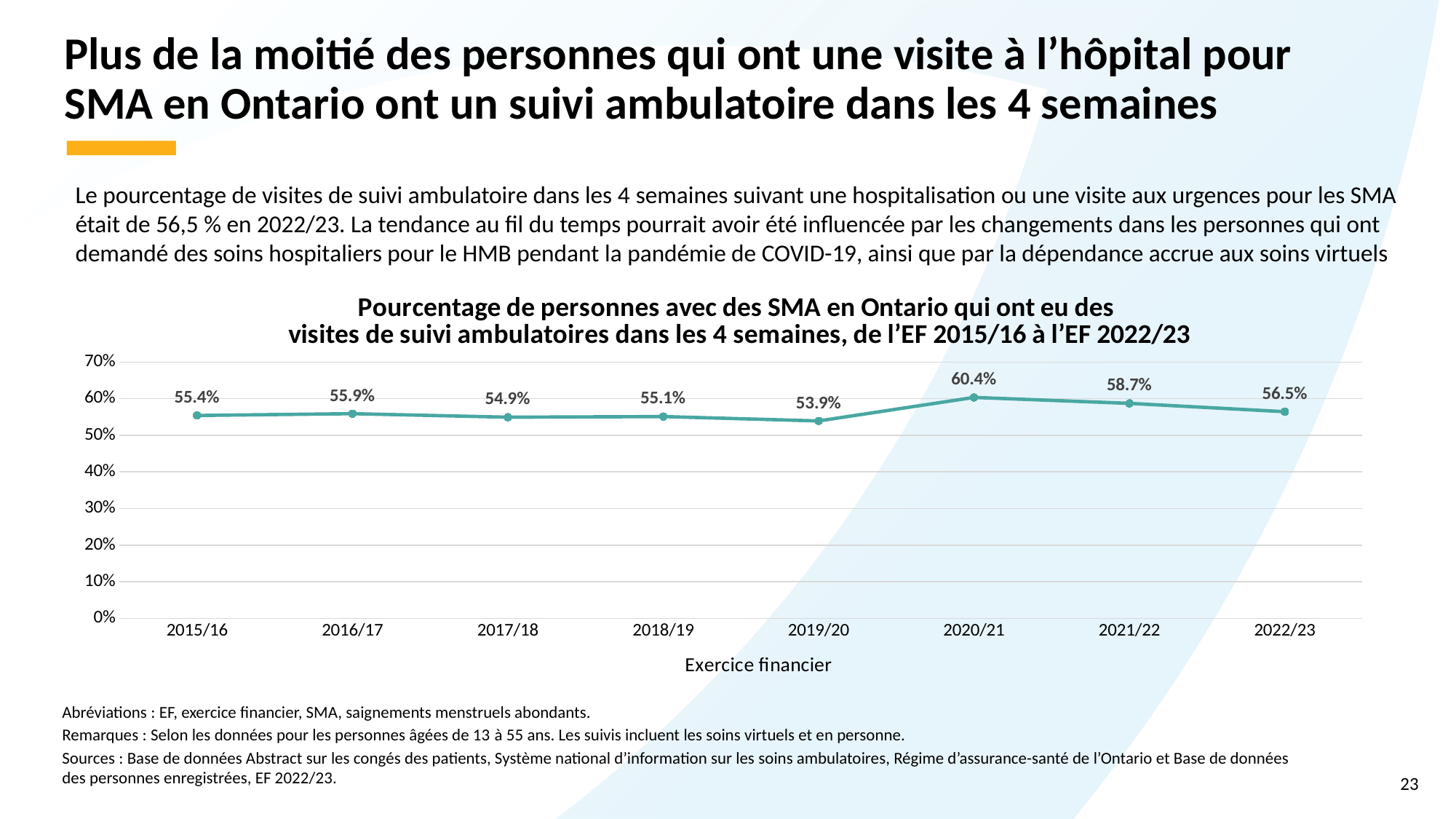
Which is larger, the value for 2016/17 or the value for 2017/18? 2016/17 How many fiscal years are plotted on the x axis? 8 What is the value for 2022/23? 56.5% What is the difference between the values for 2020/21 and 2019/20? 6.5 percentage points Which fiscal year has the lowest value? 2019/20 Is the value for 2019/20 greater or less than 50%? greater What type of chart is shown on the slide? Line chart What is the value for 2016/17? 55.9% Does the value rise or fall from 2020/21 to 2022/23? Fall What is the title of the x axis? Exercice financier What is the value for 2019/20? 53.9% Which fiscal year has the highest value? 2020/21